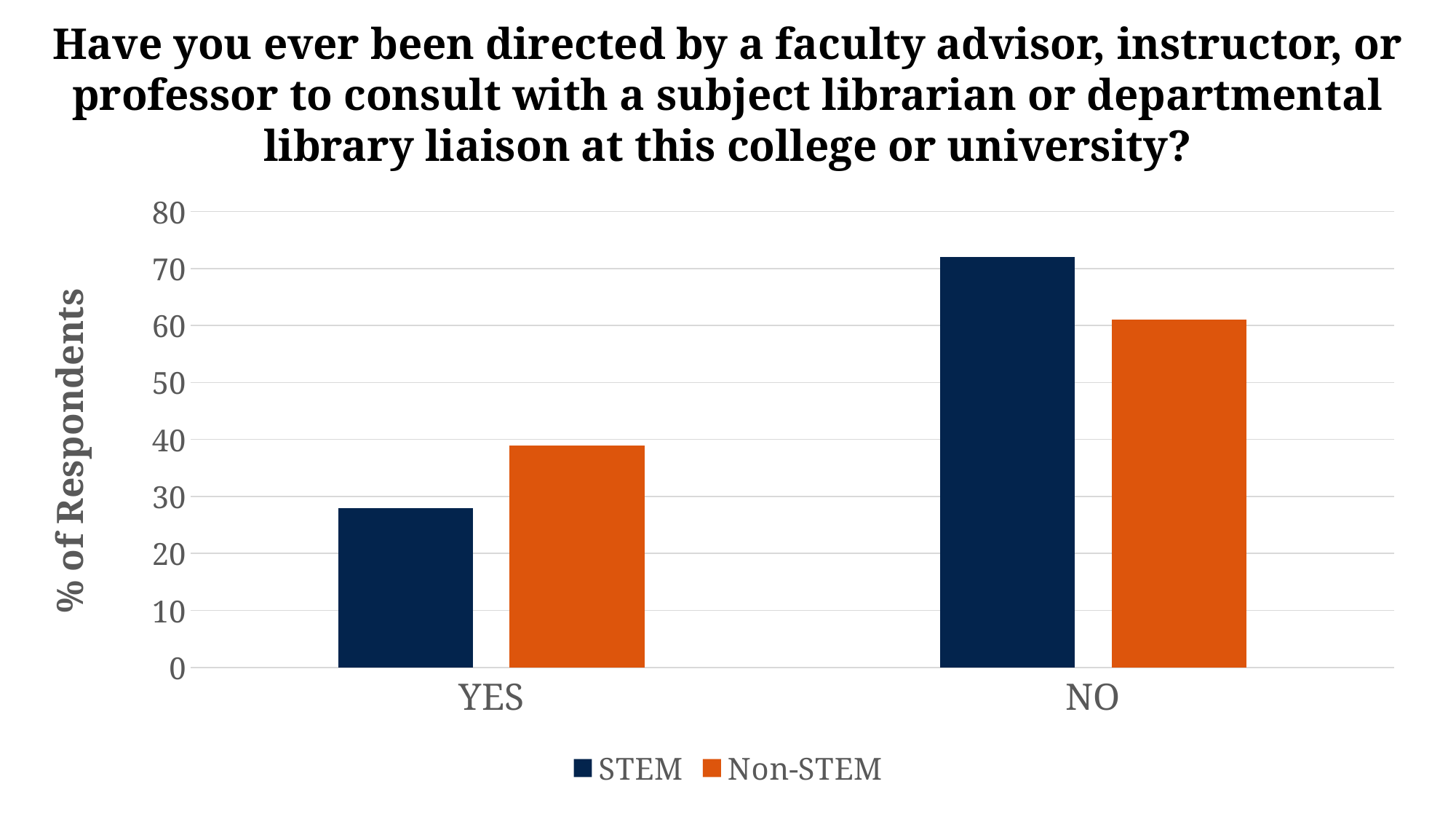
Is the STEM value for NO greater or less than 70? greater Which series is shown in orange? Non-STEM Is the STEM value for YES greater or less than 30? less What kind of chart is shown on the slide? bar chart For the YES category, which series has the larger value, STEM or Non-STEM? Non-STEM For the NO category, which series has the larger value, STEM or Non-STEM? STEM Is the Non-STEM value for YES greater or less than 30? greater Which bar is the tallest on the chart? STEM, NO What is the label of the vertical axis? % of Respondents How many series does the legend list? 2 How many categories are shown on the x axis? 2